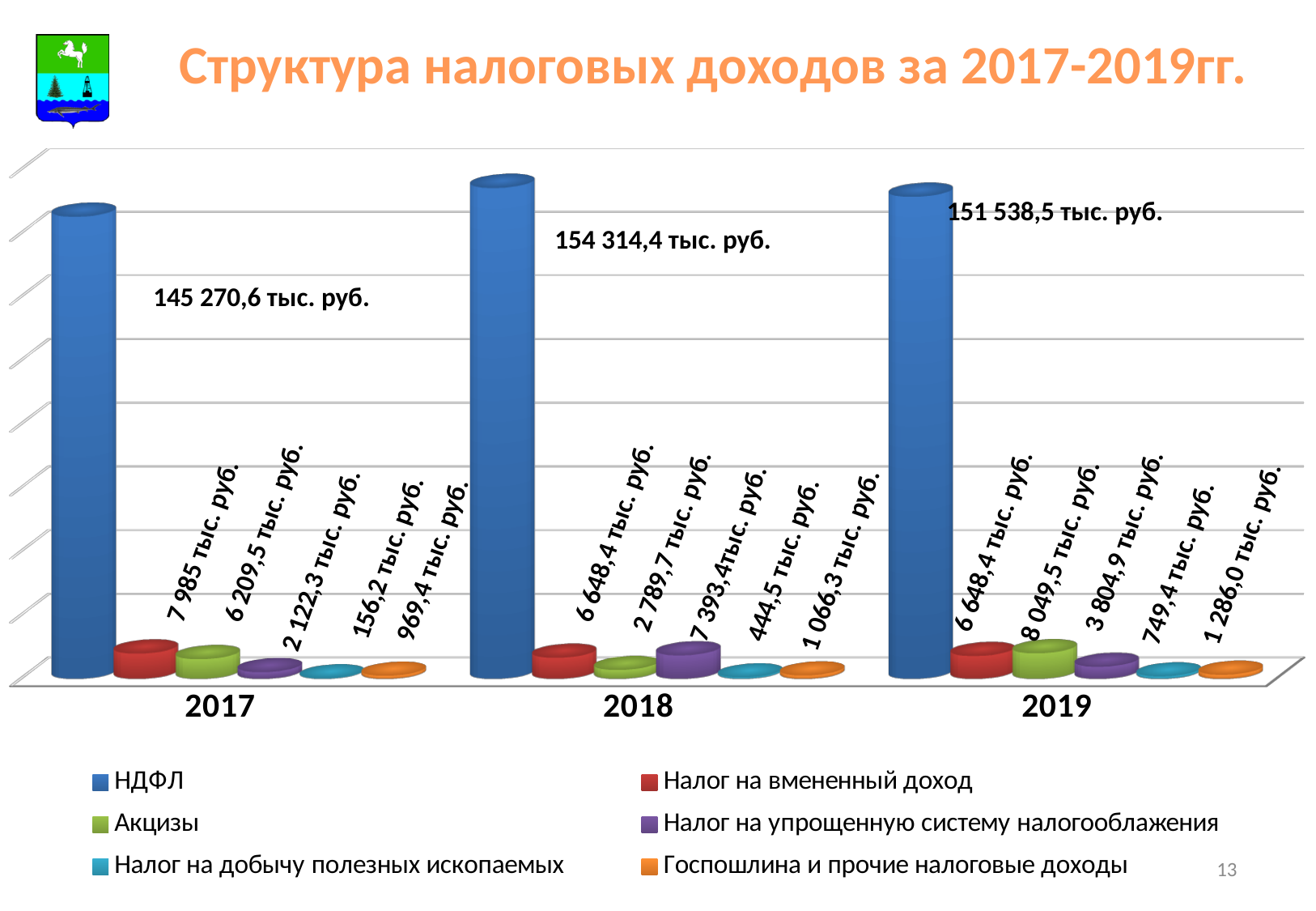
What kind of chart is shown on the slide? Bar chart What is the difference between НДФЛ in 2018 and in 2017? 9 043,8 тыс. руб. Which is larger in 2018: Налог на вмененный доход or Налог на упрощенную систему налогооблажения? Налог на упрощенную систему налогооблажения How many series does the legend list? 6 What is the difference between Акцизы in 2019 and in 2018? 5 259,8 тыс. руб. What is the value of Налог на добычу полезных ископаемых for 2017? 156,2 тыс. руб. In which year is НДФЛ lowest? 2017 What is the value of Акцизы for 2019? 8 049,5 тыс. руб. In which year is НДФЛ highest? 2018 How many years are shown on the x axis? 3 What is the value of Госпошлина и прочие налоговые доходы for 2018? 1 066,3 тыс. руб. What is the value of НДФЛ for 2018? 154 314,4 тыс. руб.